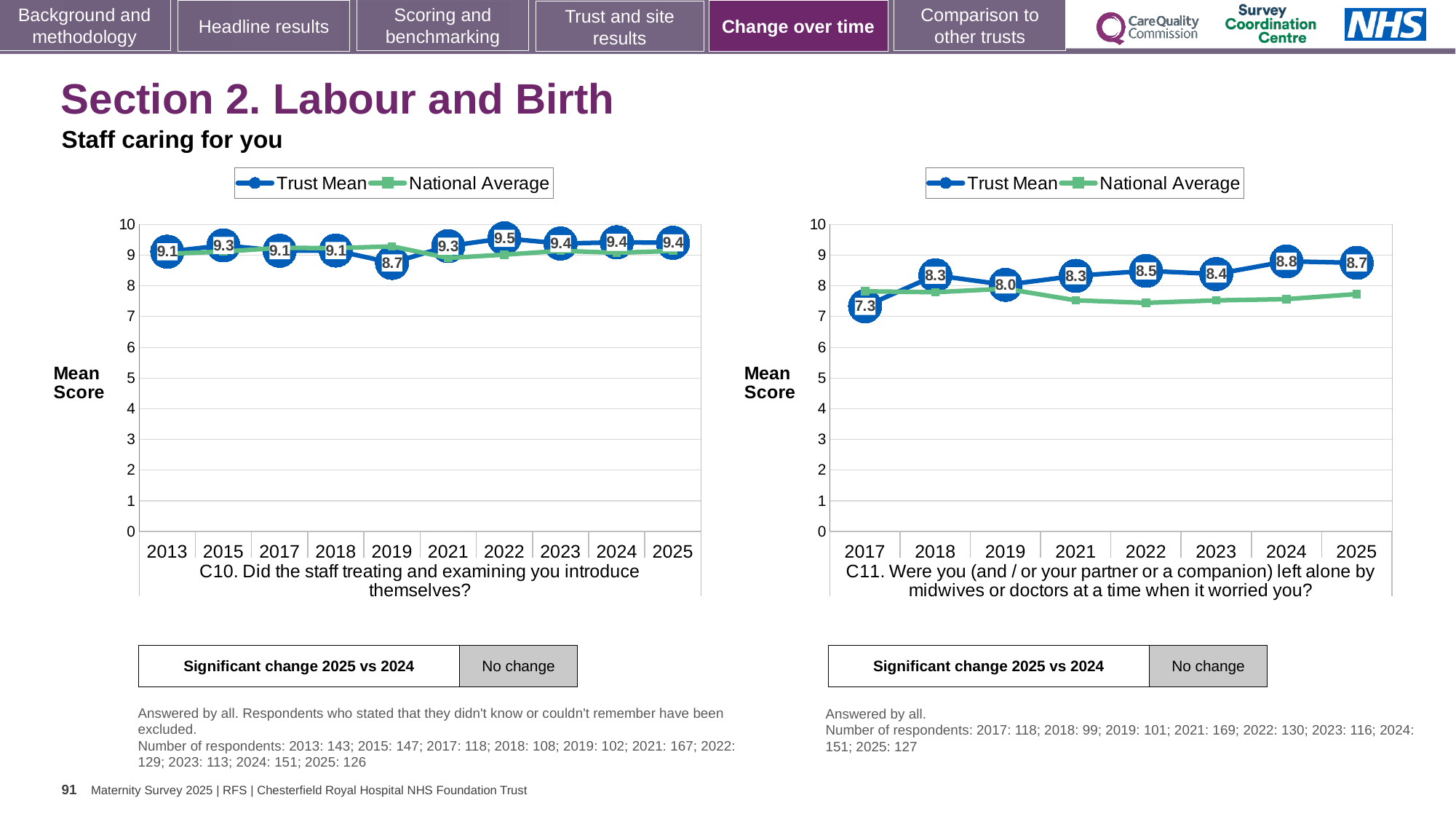
In the C11 chart (right), what is the Trust Mean for 2024? 8.8 In the C10 chart (left), what is the Trust Mean for 2022? 9.5 In the C11 chart (right), is the Trust Mean for 2025 greater or less than the Trust Mean for 2019? greater In the C10 chart (left), how many years are shown on the x axis? 10 How many series does the legend of the C11 chart (right) list? 2 In the C10 chart (left), what is the difference between the Trust Mean for 2022 and 2019? 0.8 In the C10 chart (left), which year has the highest Trust Mean? 2022 In the C10 chart (left), what is the Trust Mean for 2019? 8.7 In the C11 chart (right), which year has the lowest Trust Mean? 2017 In the C10 chart (left), which year has the lowest Trust Mean? 2019 In the C11 chart (right), is the National Average for 2025 greater or less than 8? less In the C11 chart (right), what is the Trust Mean for 2017? 7.3